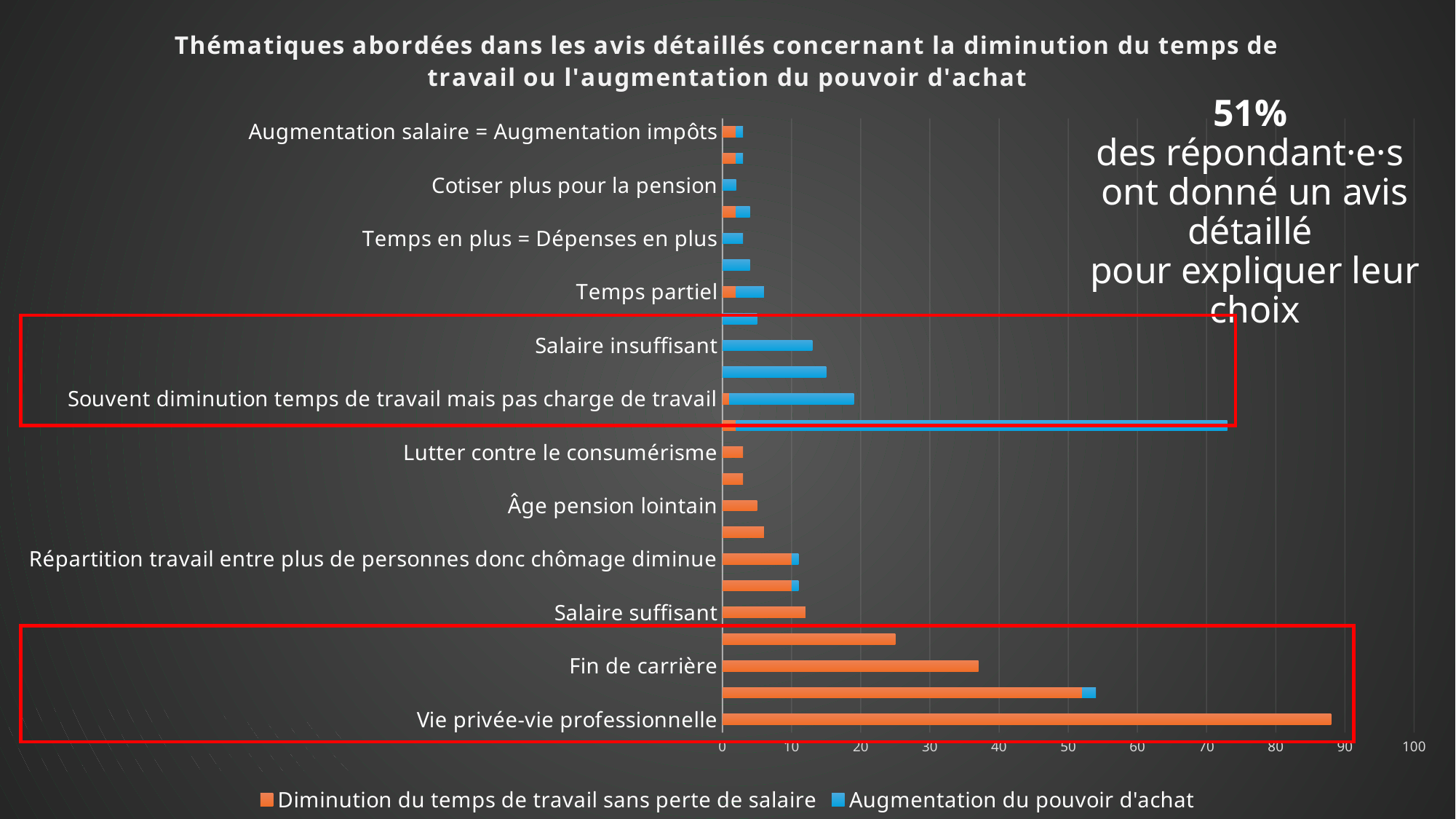
Which category has the highest value for the series 'Diminution du temps de travail sans perte de salaire'? Vie privée-vie professionnelle What kind of chart is shown on the slide? Bar chart Is the value for 'Temps partiel' in the series 'Augmentation du pouvoir d'achat' greater or less than 10? less Which series is shown in orange in the legend? Diminution du temps de travail sans perte de salaire Which is larger for the series 'Diminution du temps de travail sans perte de salaire': 'Vie privée-vie professionnelle' or 'Fin de carrière'? Vie privée-vie professionnelle Which is larger for the series 'Diminution du temps de travail sans perte de salaire': 'Fin de carrière' or 'Salaire suffisant'? Fin de carrière Is the value for 'Salaire insuffisant' in the series 'Augmentation du pouvoir d'achat' greater or less than 10? greater Is the value for 'Fin de carrière' in the series 'Diminution du temps de travail sans perte de salaire' greater or less than 30? greater How many series does the legend list? 2 Which series is shown in blue in the legend? Augmentation du pouvoir d'achat